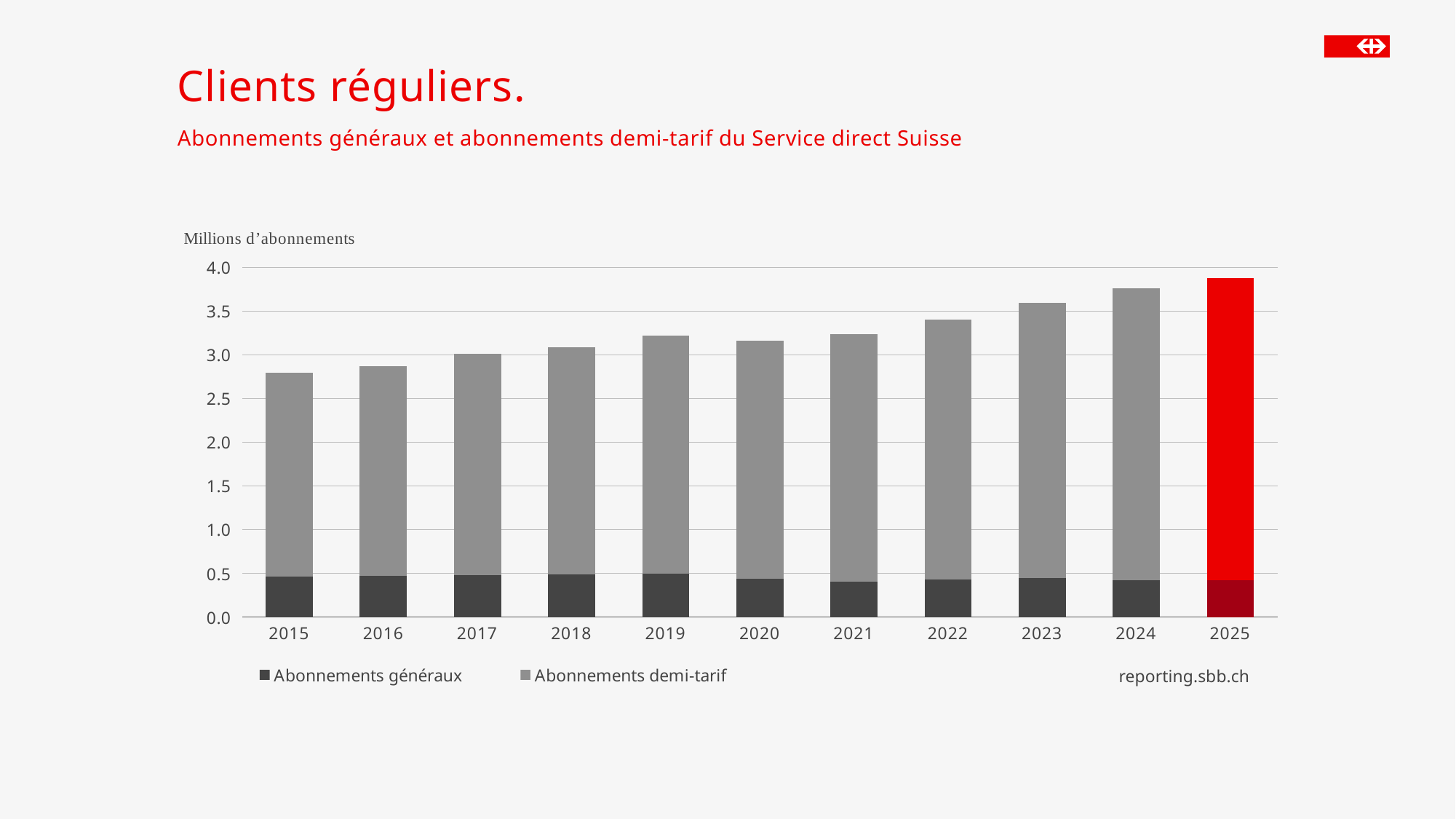
Is the total value for 2015 greater or less than 3.0? less Which year has the highest total number of subscriptions in the chart? 2025 How many series does the chart's legend list? 2 Which year has the larger total number of subscriptions, 2023 or 2024? 2024 Which year has the lowest total number of subscriptions in the chart? 2015 Is the total value for 2025 greater or less than 3.5? greater Is the value for Abonnements généraux in 2021 greater or less than 0.5? less What kind of chart is shown on the slide? Stacked bar chart What unit is given for the y axis of the chart? Millions d’abonnements How many years are shown on the x axis of the chart? 11 Do the total subscriptions generally rise or fall from 2015 to 2025? Rise